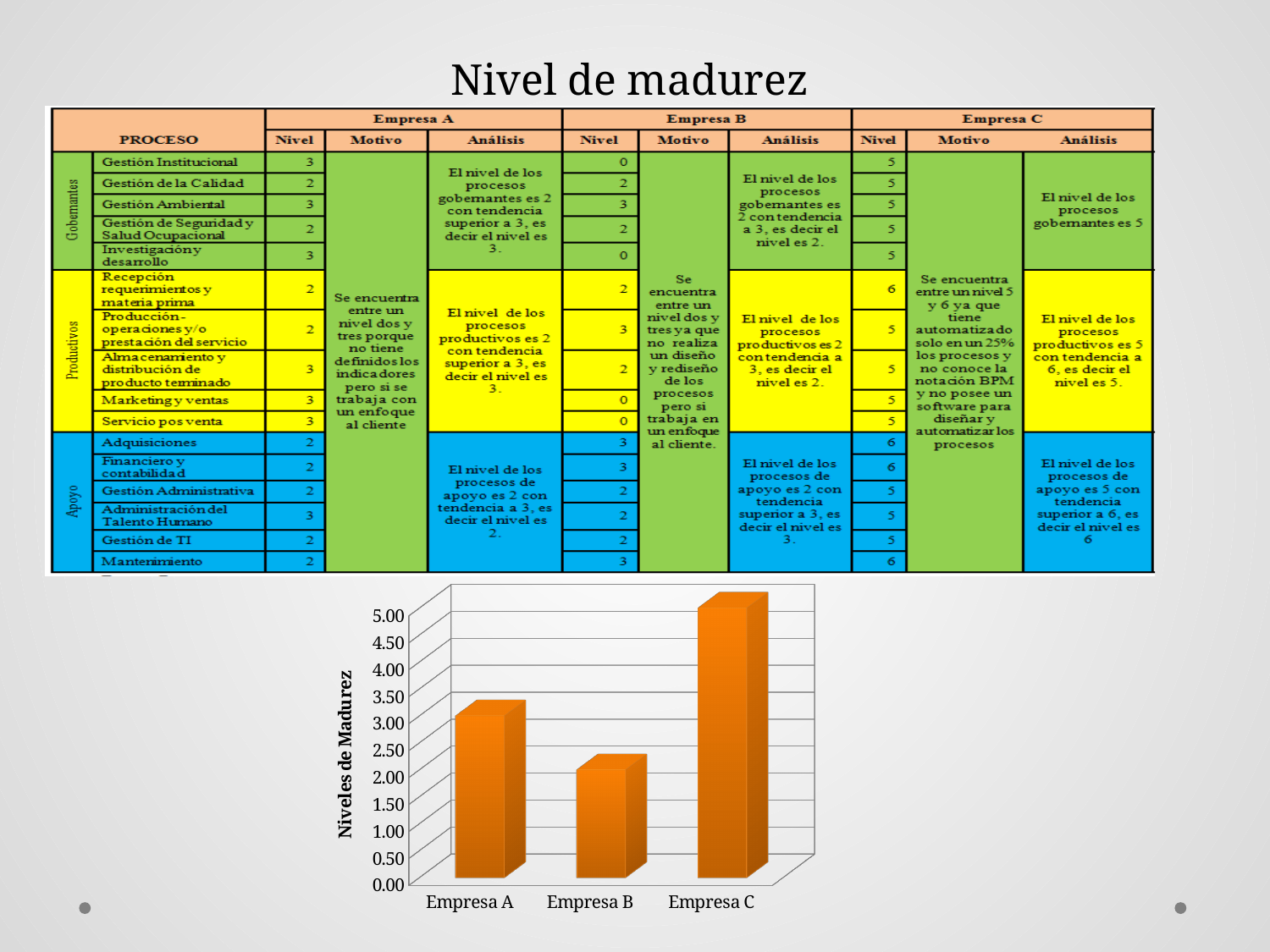
Which has a higher maturity level in the chart, Empresa A or Empresa B? Empresa A What kind of chart is shown on the slide? bar chart What is the title of the vertical axis of the chart? Niveles de Madurez Is the value for Empresa A greater or less than 2.50? greater Is the value for Empresa A greater or less than 3.50? less Is the value for Empresa C greater or less than 4.50? greater What is the highest tick value shown on the vertical axis of the chart? 5.00 Which company has the lowest bar in the chart? Empresa B Which has a higher maturity level in the chart, Empresa B or Empresa C? Empresa C Which company has the highest bar in the chart? Empresa C How many companies (categories) are plotted on the x axis of the chart? 3